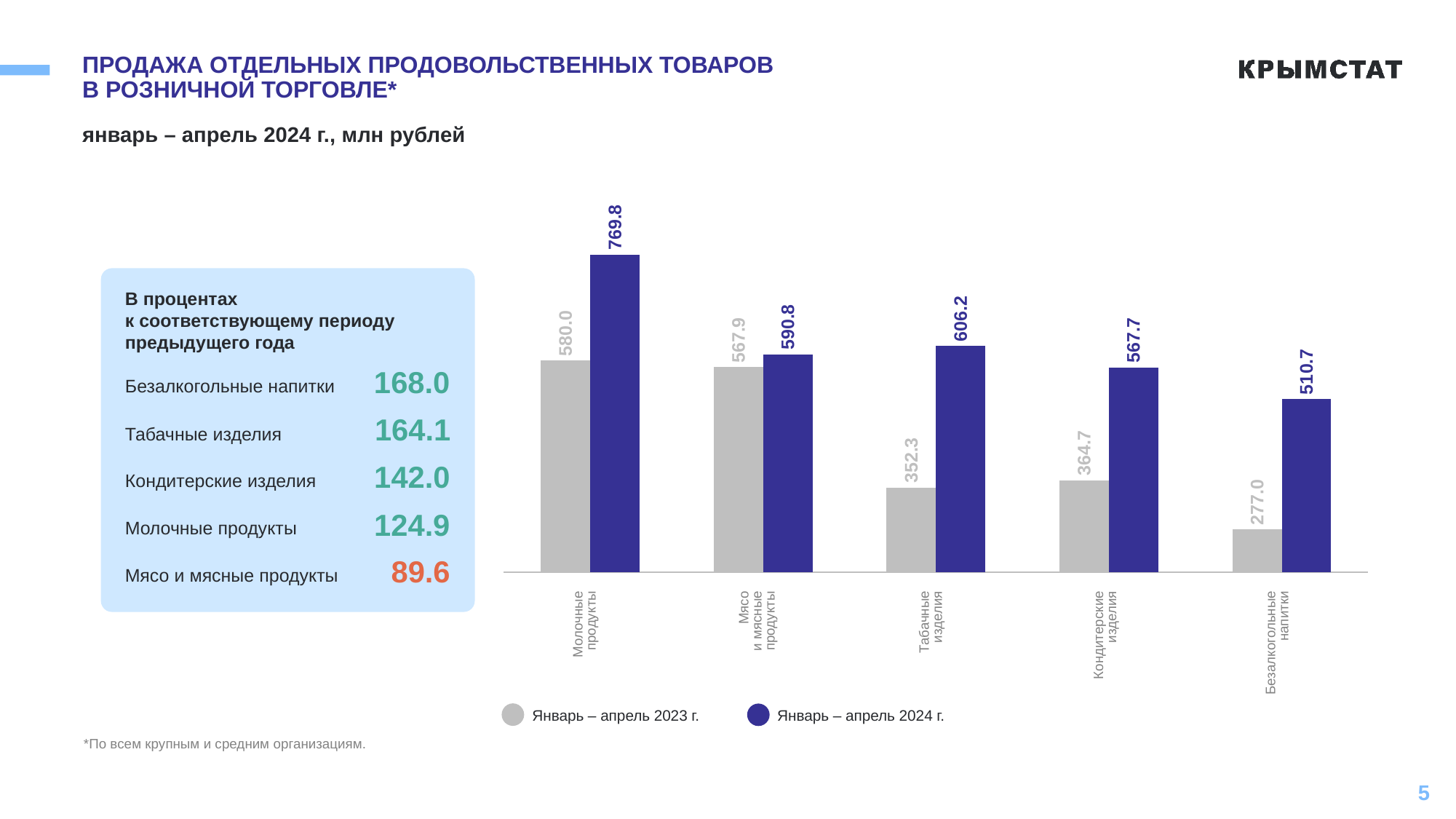
What is the difference between the 2024 and 2023 values for Кондитерские изделия? 203.0 What is the value for Безалкогольные напитки in the series Январь – апрель 2023 г.? 277.0 What type of chart is shown on the slide? Bar chart Which colour represents the series Январь – апрель 2023 г. in the chart? Grey How many product categories are shown on the x axis of the chart? 5 What is the difference between the 2024 and 2023 values for Молочные продукты? 189.8 Which is larger for Мясо и мясные продукты: the value for Январь – апрель 2023 г. or Январь – апрель 2024 г.? Январь – апрель 2024 г. Which category has the highest value in the series Январь – апрель 2024 г.? Молочные продукты What is the value for Молочные продукты in the series Январь – апрель 2024 г.? 769.8 Which category has the lowest value in the series Январь – апрель 2023 г.? Безалкогольные напитки How many series does the legend list? 2 What is the value for Табачные изделия in the series Январь – апрель 2024 г.? 606.2